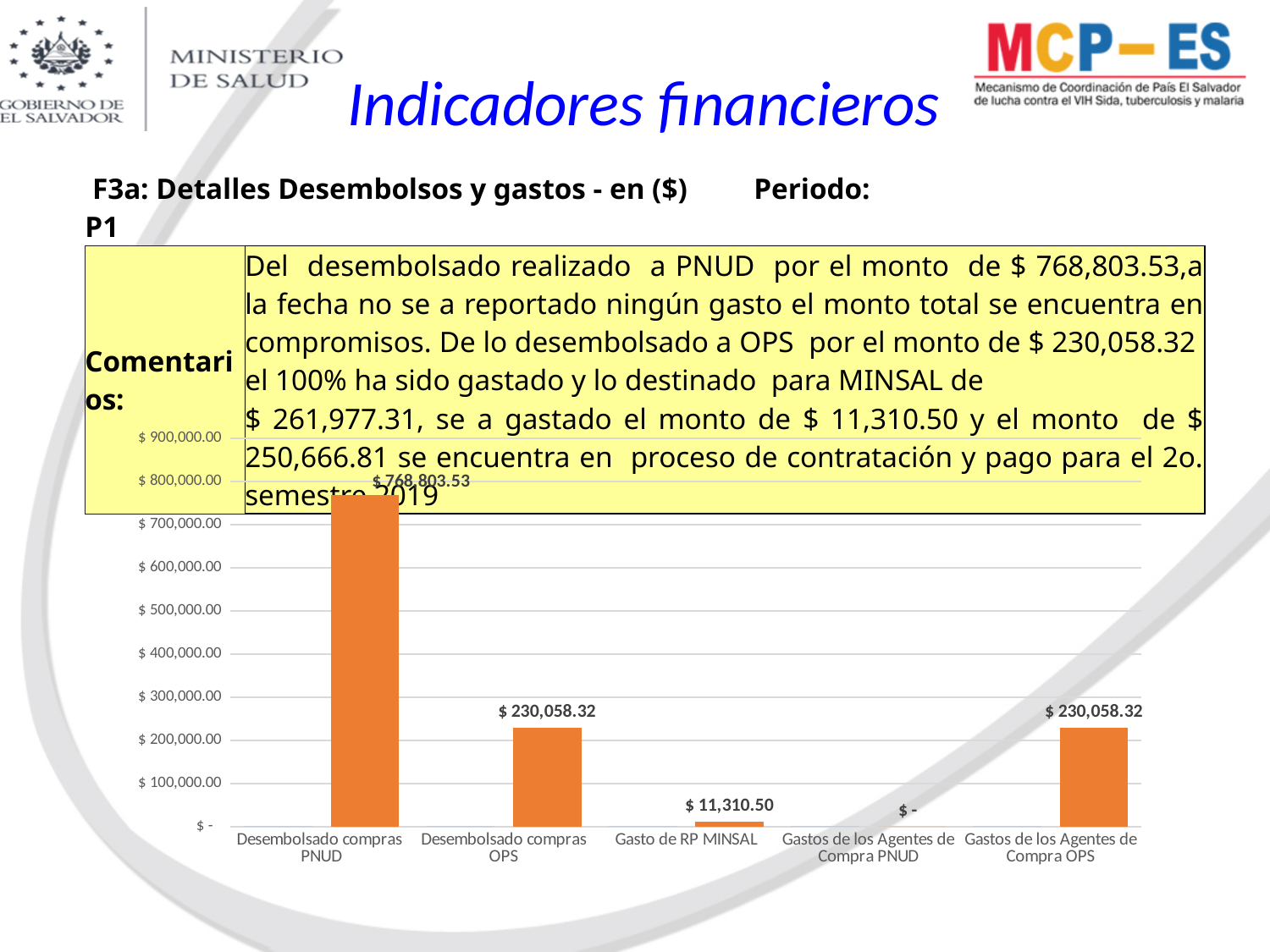
Which category has the lowest value? Gastos de los Agentes de Compra PNUD Which is larger, Desembolsado compras OPS or Gasto de RP MINSAL? Desembolsado compras OPS What kind of chart is shown on the slide? bar chart What is the value for Gastos de los Agentes de Compra OPS? $ 230,058.32 Which category has the highest value? Desembolsado compras PNUD How many categories are shown on the x axis of the chart? 5 What is the value for Desembolsado compras PNUD? $ 768,803.53 What is the difference between Desembolsado compras PNUD and Desembolsado compras OPS? $ 538,745.21 What is the value for Gasto de RP MINSAL? $ 11,310.50 What is the value for Desembolsado compras OPS? $ 230,058.32 Is the value for Desembolsado compras PNUD greater or less than $ 700,000.00? greater What is the value shown for Gastos de los Agentes de Compra PNUD? $ -